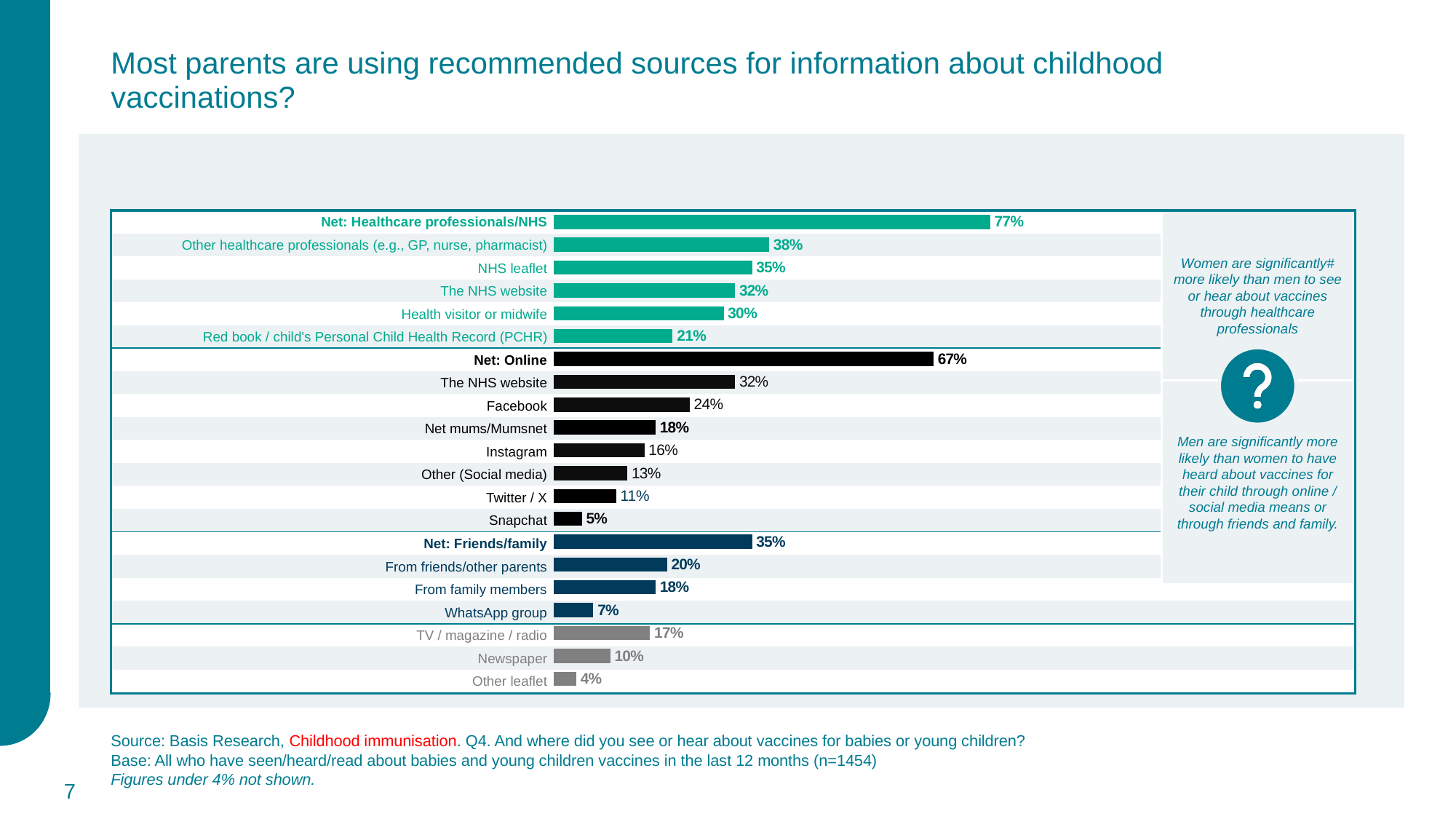
Which category has the highest value in the chart? Net: Healthcare professionals/NHS What is the difference between the values for Instagram and Snapchat? 11 percentage points What percentage is shown for Red book / child's Personal Child Health Record (PCHR)? 21% Which category has the lowest value in the chart? Other leaflet What is the value for WhatsApp group? 7% Which is larger, the value for Newspaper or the value for Twitter / X? Twitter / X What percentage of parents saw or heard about vaccines via Facebook? 24% What is the value shown for Net: Online? 67% What type of chart is shown on the slide? Bar chart What is the difference between Net: Healthcare professionals/NHS and Net: Online? 10 percentage points How many bars are plotted in the chart? 21 What percentage is shown for Health visitor or midwife? 30%